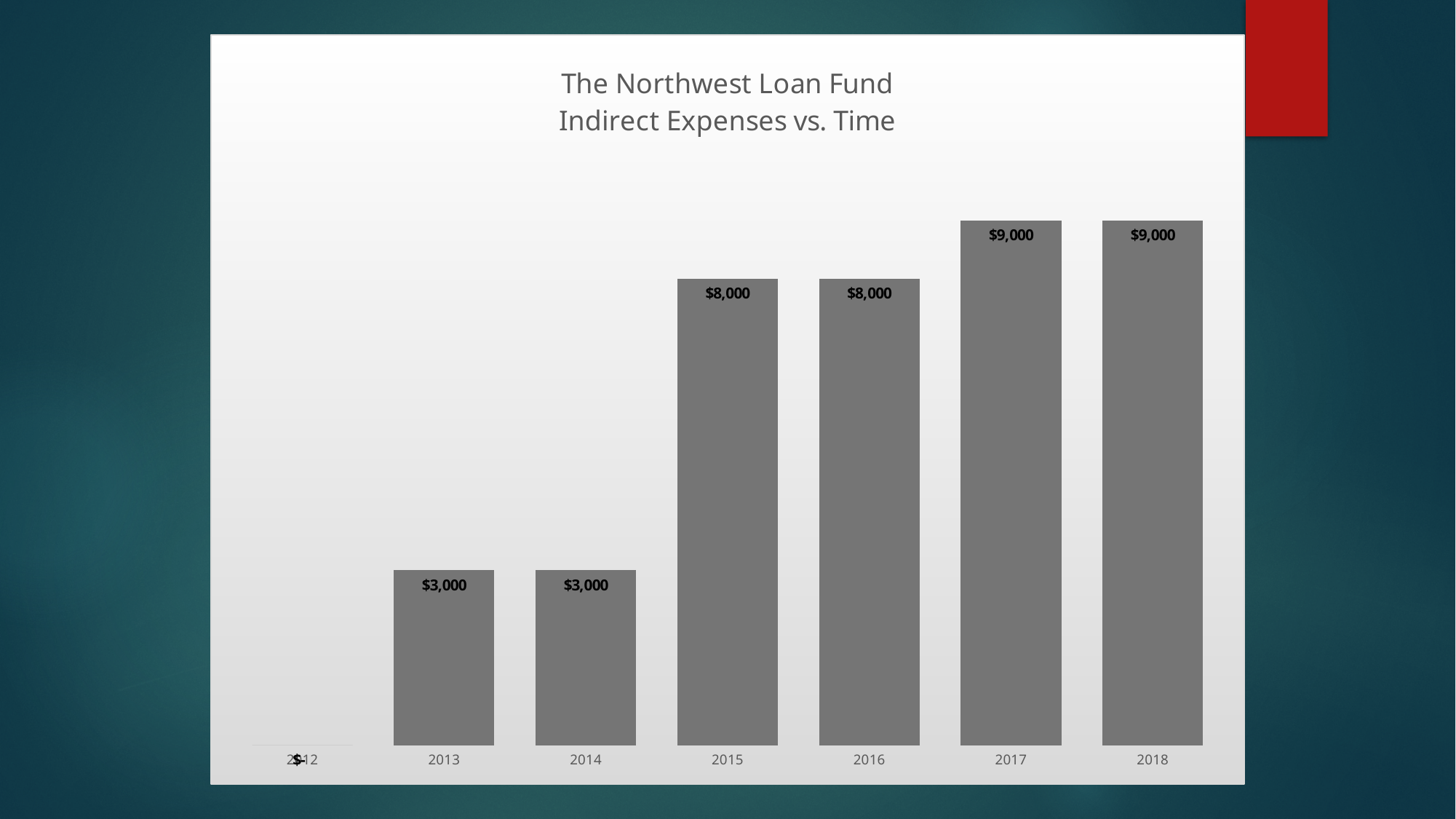
Do the values generally rise or fall from 2013 to 2018? rise What is the difference between the values for 2017 and 2016? $1,000 What kind of chart is this? bar chart How many years are shown on the x axis? 7 What is the value for 2013? $3,000 What is the value for 2018? $9,000 What is the value for 2015? $8,000 Which is larger, the value for 2016 or the value for 2018? 2018 What is the value for 2017? $9,000 What is the difference between the values for 2015 and 2013? $5,000 What is the value for 2016? $8,000 Which is larger, the value for 2014 or the value for 2015? 2015